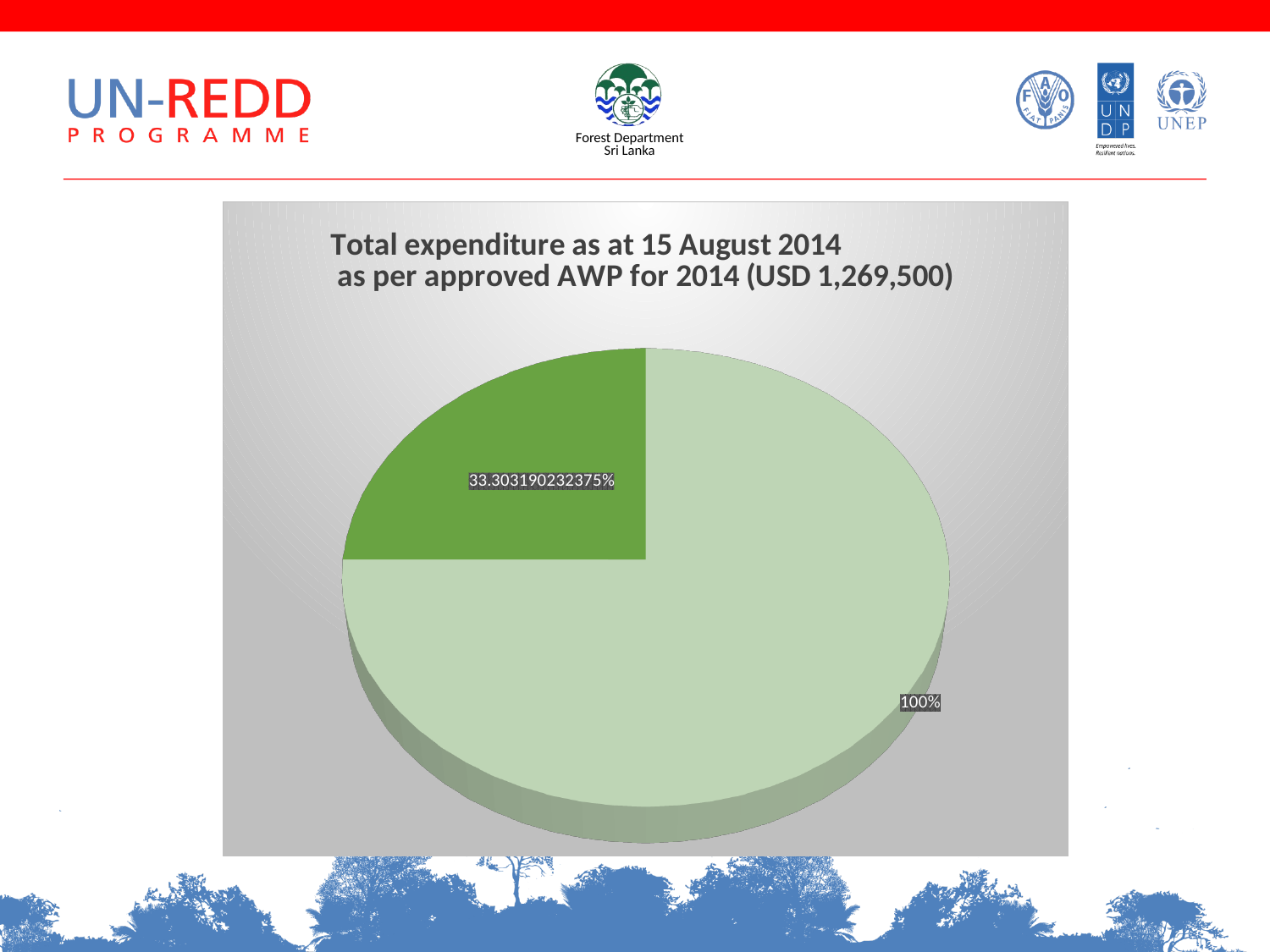
What value is printed on the dark green slice of the pie chart? 33.303190232375% What is the title of the pie chart? Total expenditure as at 15 August 2014 as per approved AWP for 2014 (USD 1,269,500) Which slice of the pie chart is larger, the dark green one or the light green one? The light green one How many slices does the pie chart have? 2 What kind of chart is shown on the slide? Pie chart Which slice of the pie chart is the smallest? The dark green slice (33.303190232375%) What value is printed on the light green slice of the pie chart? 100% What approved AWP amount for 2014 is stated in the chart title? USD 1,269,500 Is the value labelled on the dark green slice greater or less than 50%? less